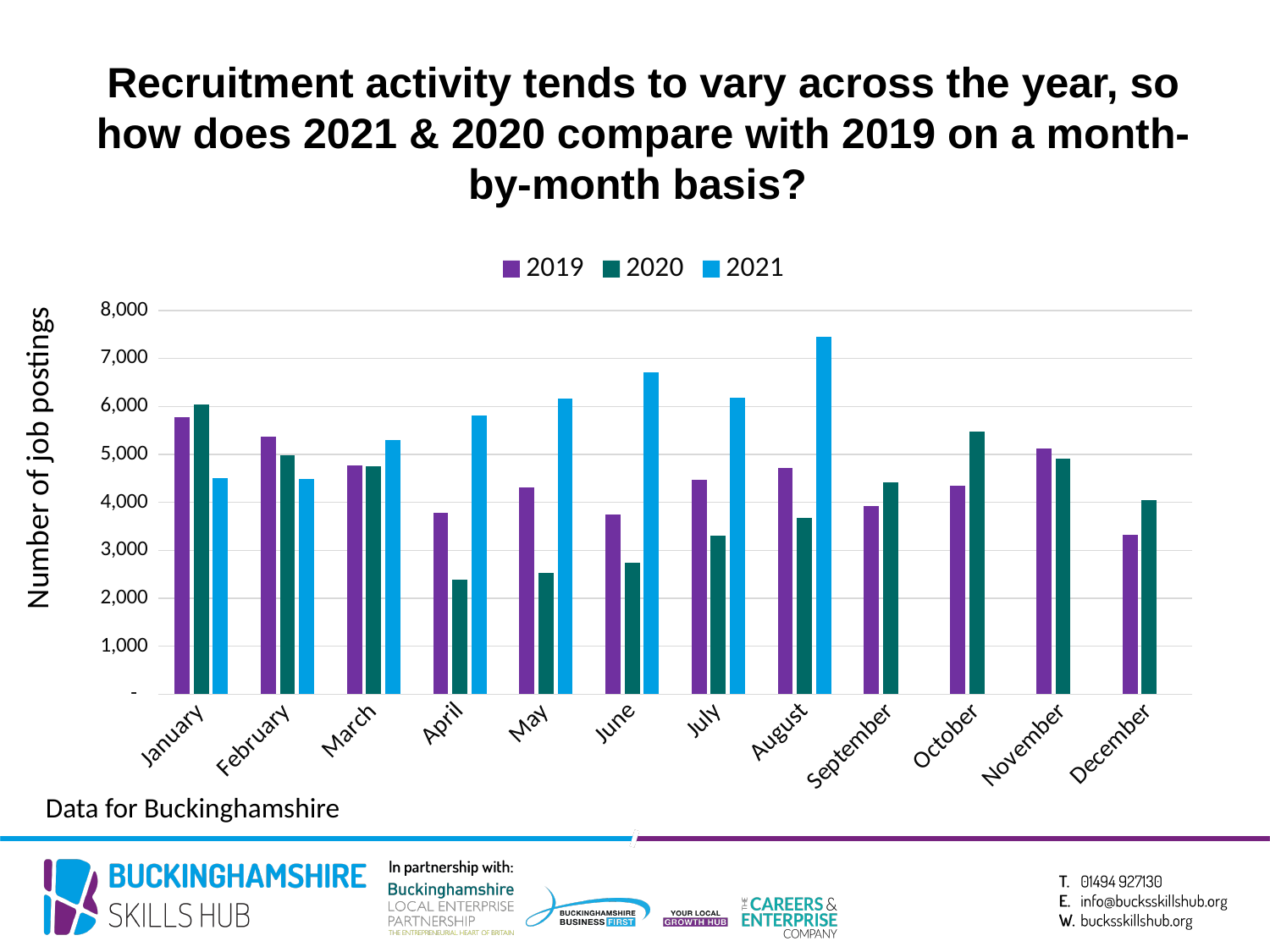
Is the 2021 value for August greater or less than 7,000? greater Does the 2021 series generally rise or fall from January to August? rise For January, which series has the larger value, 2019 or 2021? 2019 How many months are shown on the x axis? 12 For June, which series has the larger value, 2020 or 2021? 2021 How many series does the legend list? 3 What is the label on the vertical axis? Number of job postings Is the 2020 value for April greater or less than 3,000? less What kind of chart is shown on the slide? bar chart In which month is the 2020 value highest? January In which month is the 2019 value lowest? December In which month is the 2021 value highest? August